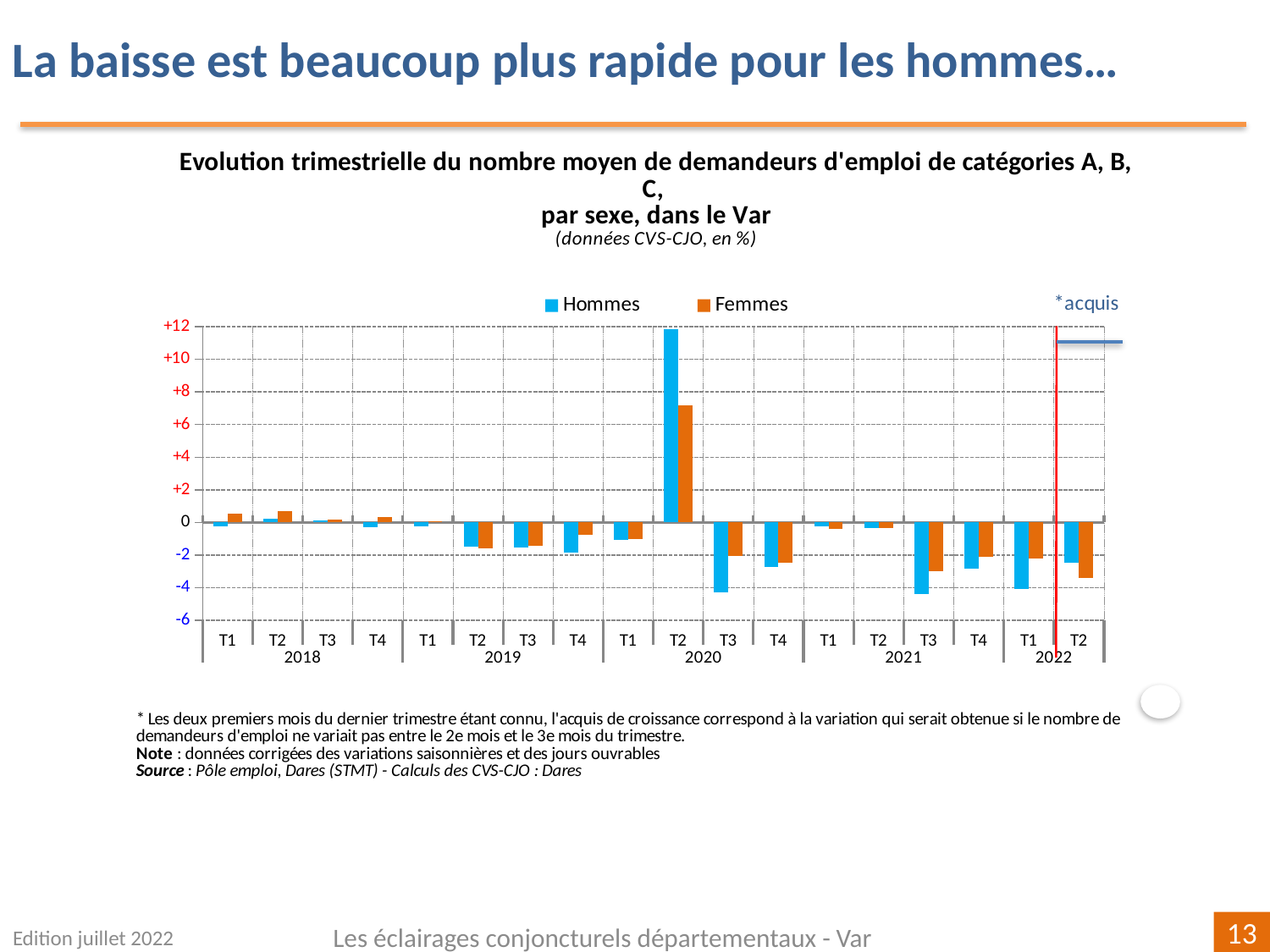
In which quarter is the value for Hommes highest? T2 2020 In T2 2020, which series has the larger value, Hommes or Femmes? Hommes In T1 2022, which series has the lower (more negative) value, Hommes or Femmes? Hommes How many series does the legend list? 2 What kind of chart is shown on the slide? bar chart Is the value for Hommes in T3 2020 greater or less than -4? less Is the value for Hommes in T2 2020 greater or less than +10? greater What are the two series named in the legend? Hommes and Femmes Is the value for Femmes in T2 2020 greater or less than +8? less In which quarter is the value for Femmes highest? T2 2020 How many quarters are plotted along the x axis? 18